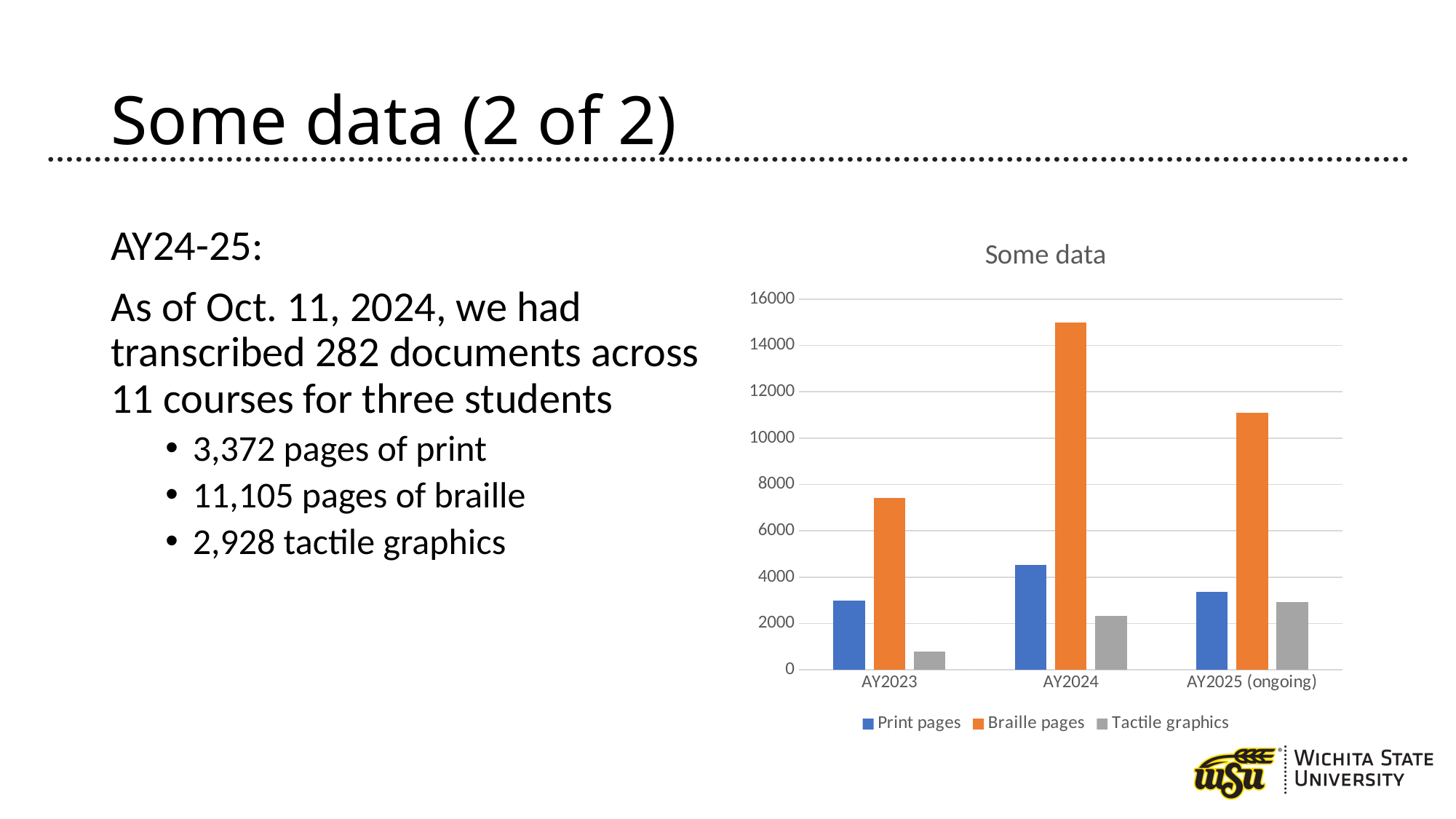
Is the value for Tactile graphics in AY2023 greater or less than 2000? less How many academic year categories are shown on the x axis of the chart? 3 How many series does the chart legend list? 3 Which is larger, Print pages in AY2023 or Print pages in AY2024? AY2024 Which academic year has the highest value for Braille pages? AY2024 Which academic year has the lowest value for Tactile graphics? AY2023 Which is larger, Braille pages in AY2023 or Braille pages in AY2025 (ongoing)? AY2025 (ongoing) Is the value for Braille pages in AY2024 greater or less than 14000? greater What is the title of the chart? Some data Is the value for Print pages in AY2025 (ongoing) greater or less than 2000? greater What kind of chart is shown on the slide? bar chart Do the Tactile graphics values rise or fall from AY2023 to AY2025 (ongoing)? rise